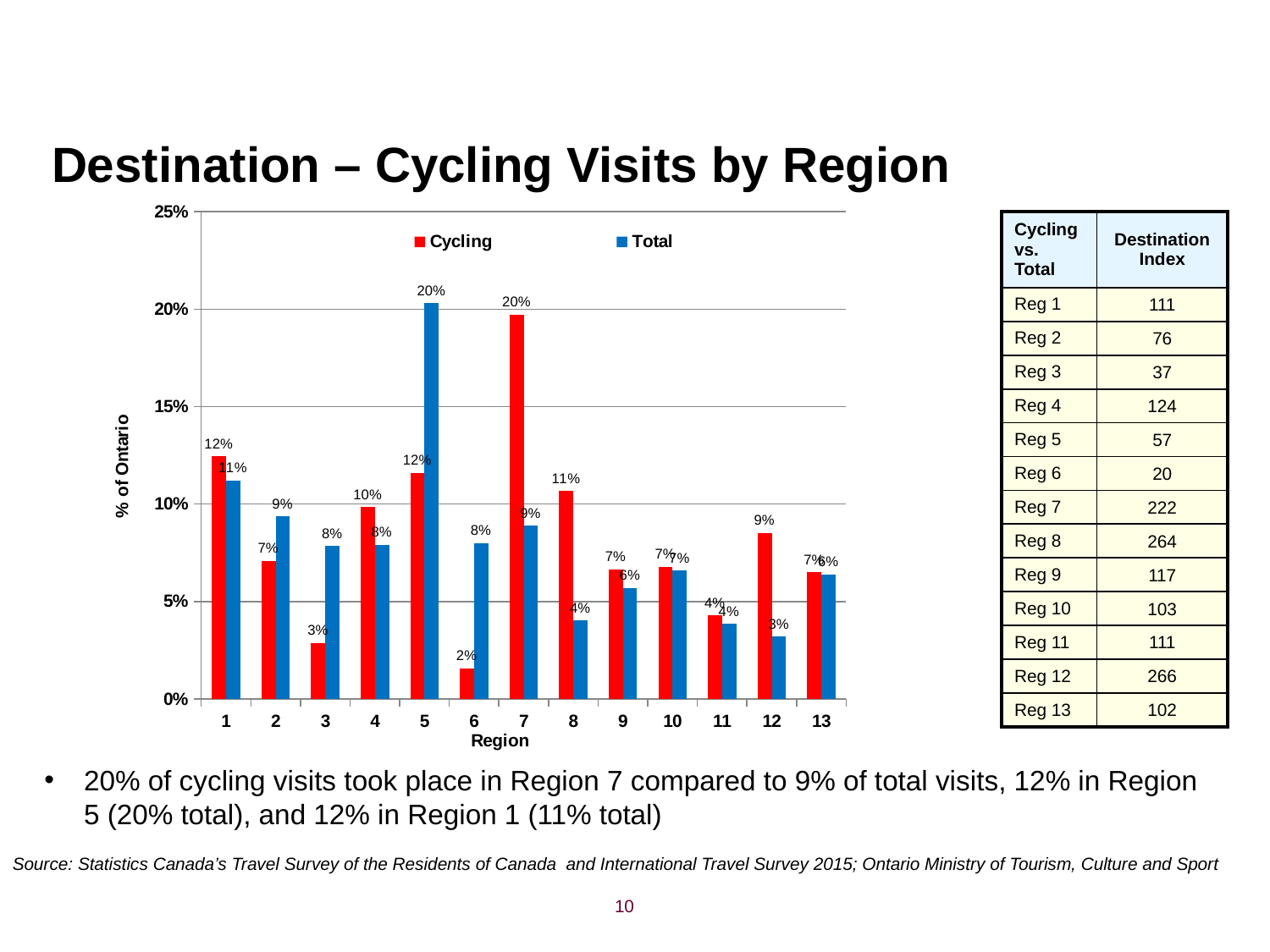
Which region has the highest Total value? Region 5 Which region has the highest Cycling value? Region 7 How many regions are shown on the x axis? 13 What is the Cycling value for Region 6? 2% What is the difference between the Cycling and Total values for Region 7? 11% What is the Cycling value for Region 7? 20% For Region 3, which is larger, the Cycling value or the Total value? Total What type of chart is shown? Bar chart What is the Total value for Region 12? 3% What is the Total value for Region 5? 20% Which region has the lowest Cycling value? Region 6 How many series does the legend list? 2